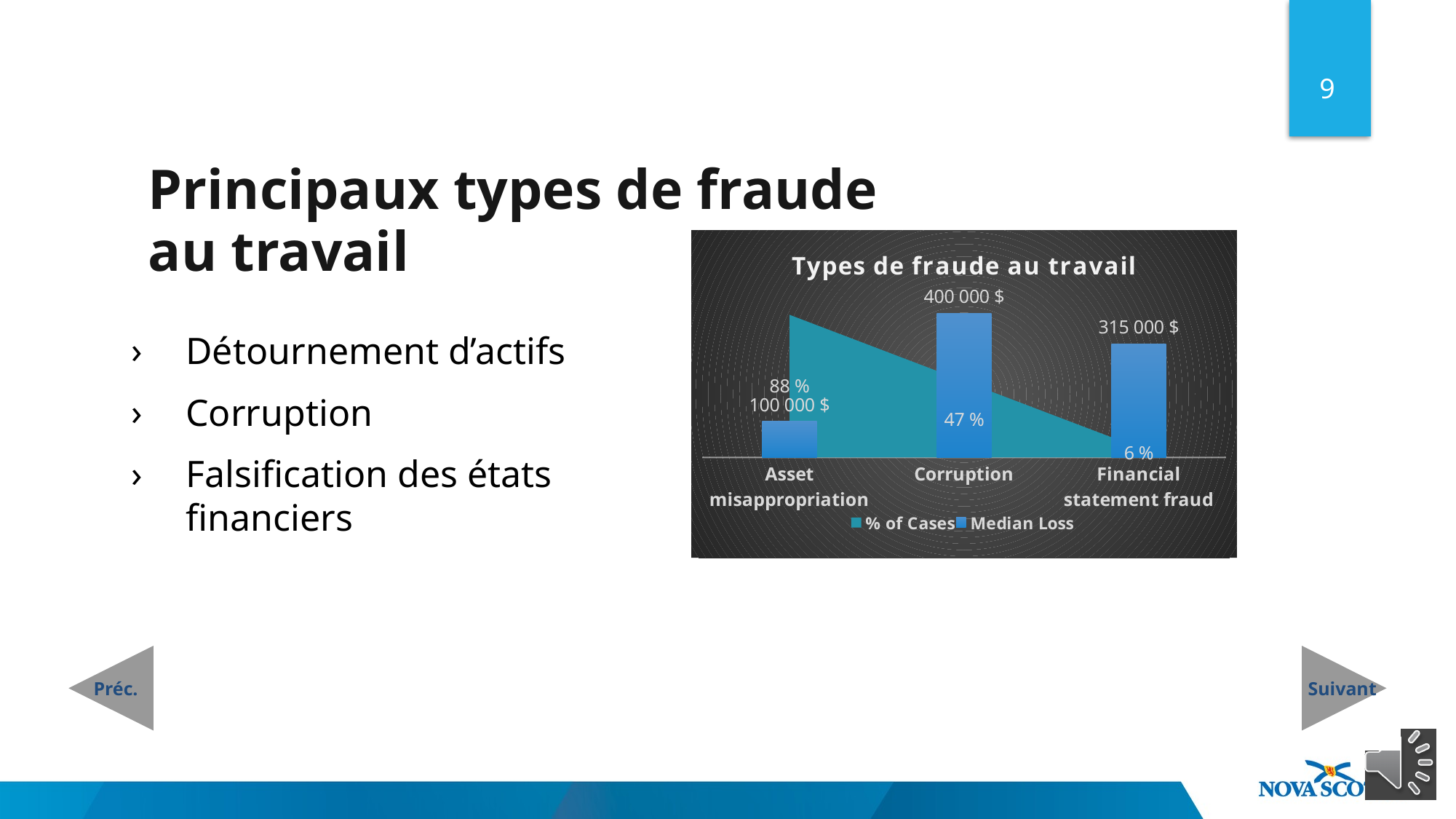
What is the Median Loss for Financial statement fraud? 315 000 $ What is the difference in Median Loss between Corruption and Financial statement fraud? 85 000 $ What is the % of Cases for Asset misappropriation? 88 % Which has a higher % of Cases, Corruption or Financial statement fraud? Corruption Does the % of Cases rise or fall from Asset misappropriation to Financial statement fraud? fall What is the title of the chart? Types de fraude au travail How many series does the legend list? 2 What is the Median Loss for Asset misappropriation? 100 000 $ What is the % of Cases for Financial statement fraud? 6 % Which category has the lowest % of Cases? Financial statement fraud Which category has the highest Median Loss? Corruption What is the Median Loss for Corruption? 400 000 $